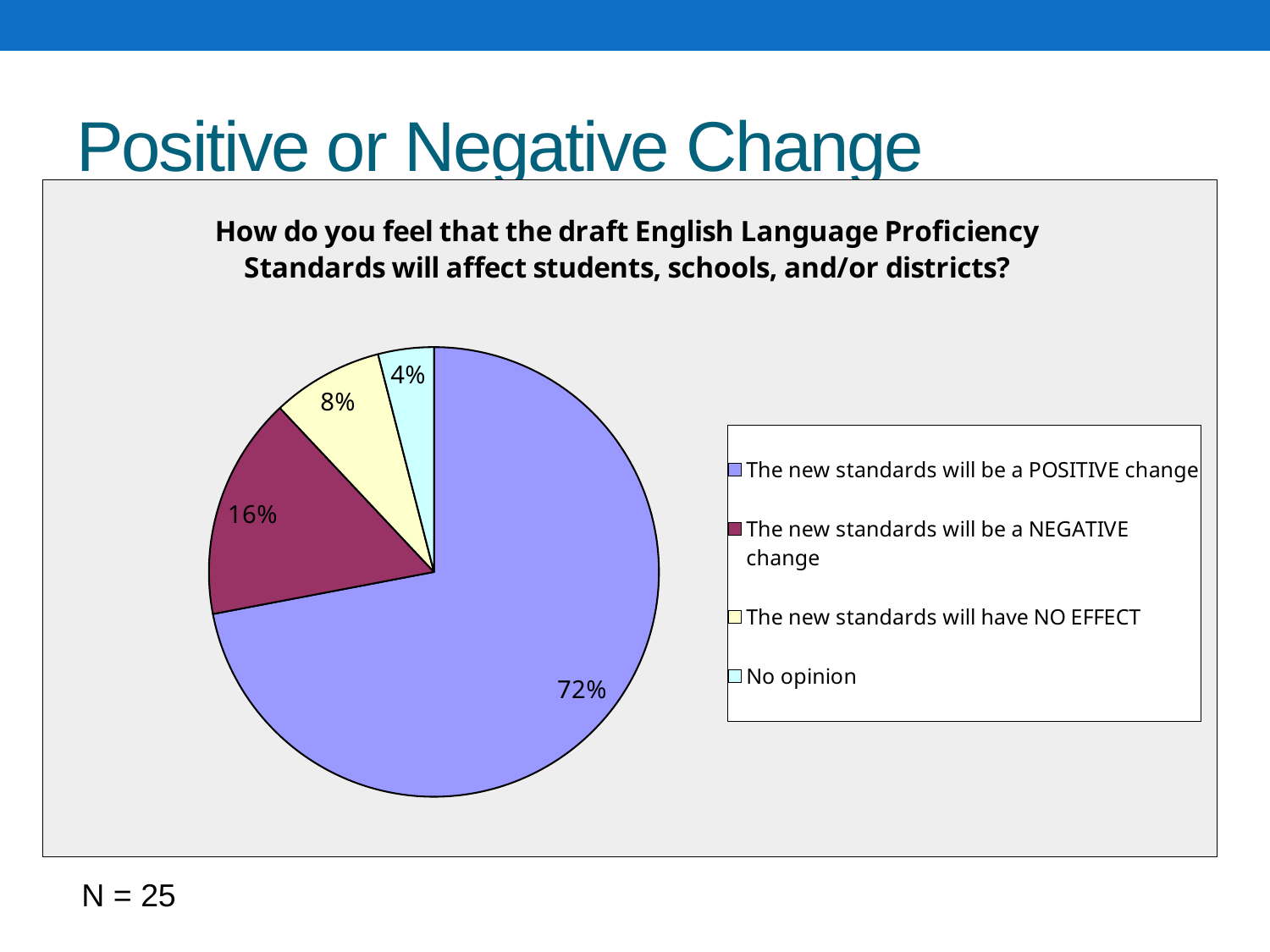
What kind of chart is shown on the slide? pie chart How many entries does the legend list? 4 What is the difference in percentage points between the POSITIVE change and NEGATIVE change responses? 56 What percentage of respondents had no opinion? 4% What percentage of respondents said the new standards will have NO EFFECT? 8% What is the chart's title? How do you feel that the draft English Language Proficiency Standards will affect students, schools, and/or districts? How many slices does the pie chart have? 4 What percentage of respondents said the new standards will be a POSITIVE change? 72% Which response has the smallest share of the pie? No opinion Which is larger: the share for NO EFFECT or the share for No opinion? The new standards will have NO EFFECT What percentage of respondents said the new standards will be a NEGATIVE change? 16% Which response has the largest share of the pie? The new standards will be a POSITIVE change